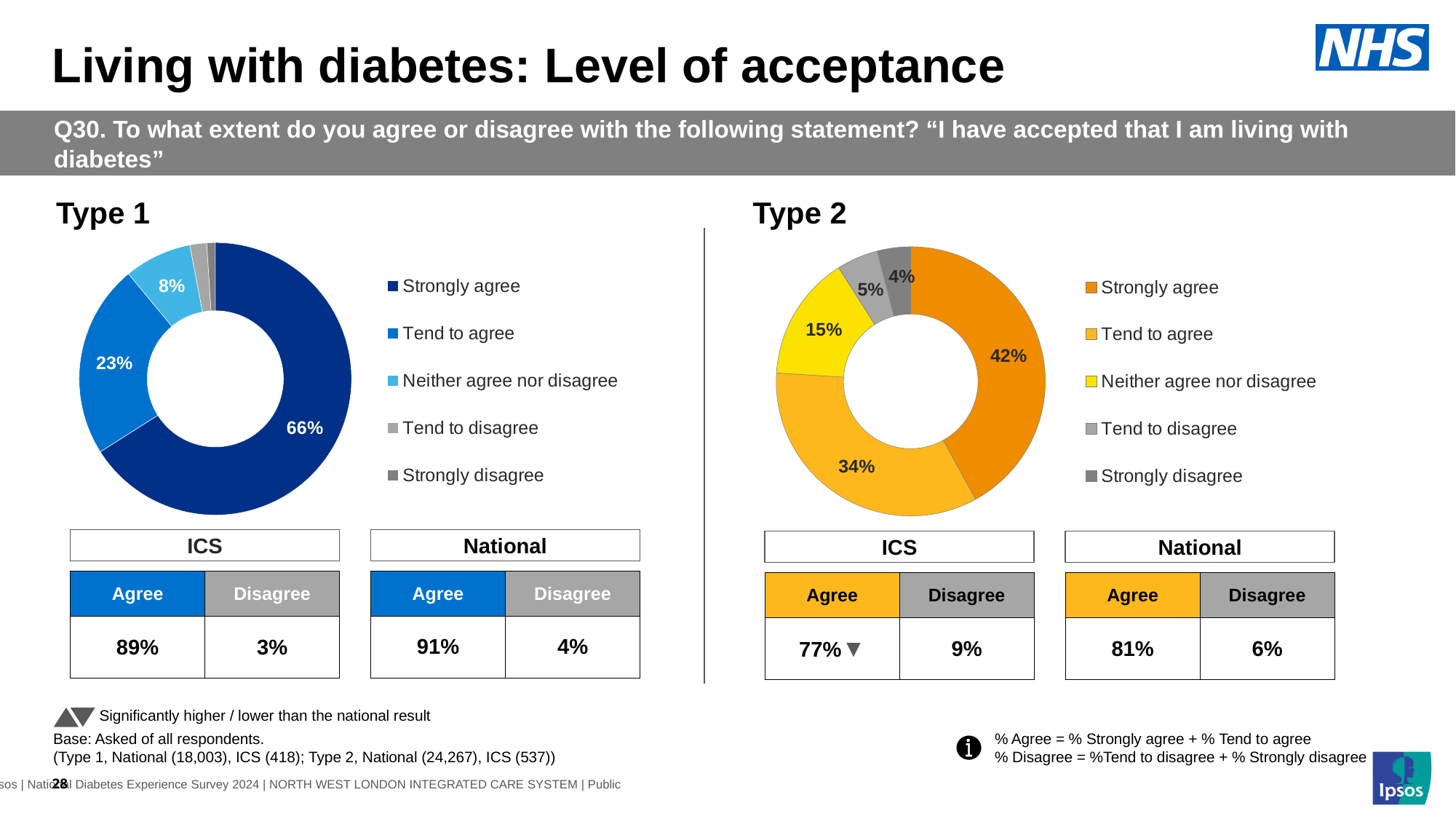
What kind of chart is used for Type 1? Donut (pie) chart In the Type 2 chart, what percentage of respondents neither agree nor disagree? 15% In the Type 2 chart, which category has the smallest share? Strongly disagree In the Type 2 chart, what percentage of respondents tend to disagree? 5% In the Type 2 chart, what colour represents Neither agree nor disagree? Yellow In the Type 1 chart, what percentage of respondents tend to agree? 23% In the Type 2 chart, which category has the largest share? Strongly agree In the Type 1 chart, what percentage of respondents strongly agree? 66% In the Type 1 chart, what is the difference between the Strongly agree and Tend to agree shares? 43 percentage points Which chart has a larger Strongly agree share, Type 1 or Type 2? Type 1 In the Type 2 chart, what is the difference between the Strongly agree and Tend to agree shares? 8 percentage points How many categories does the legend of the Type 1 chart list? 5